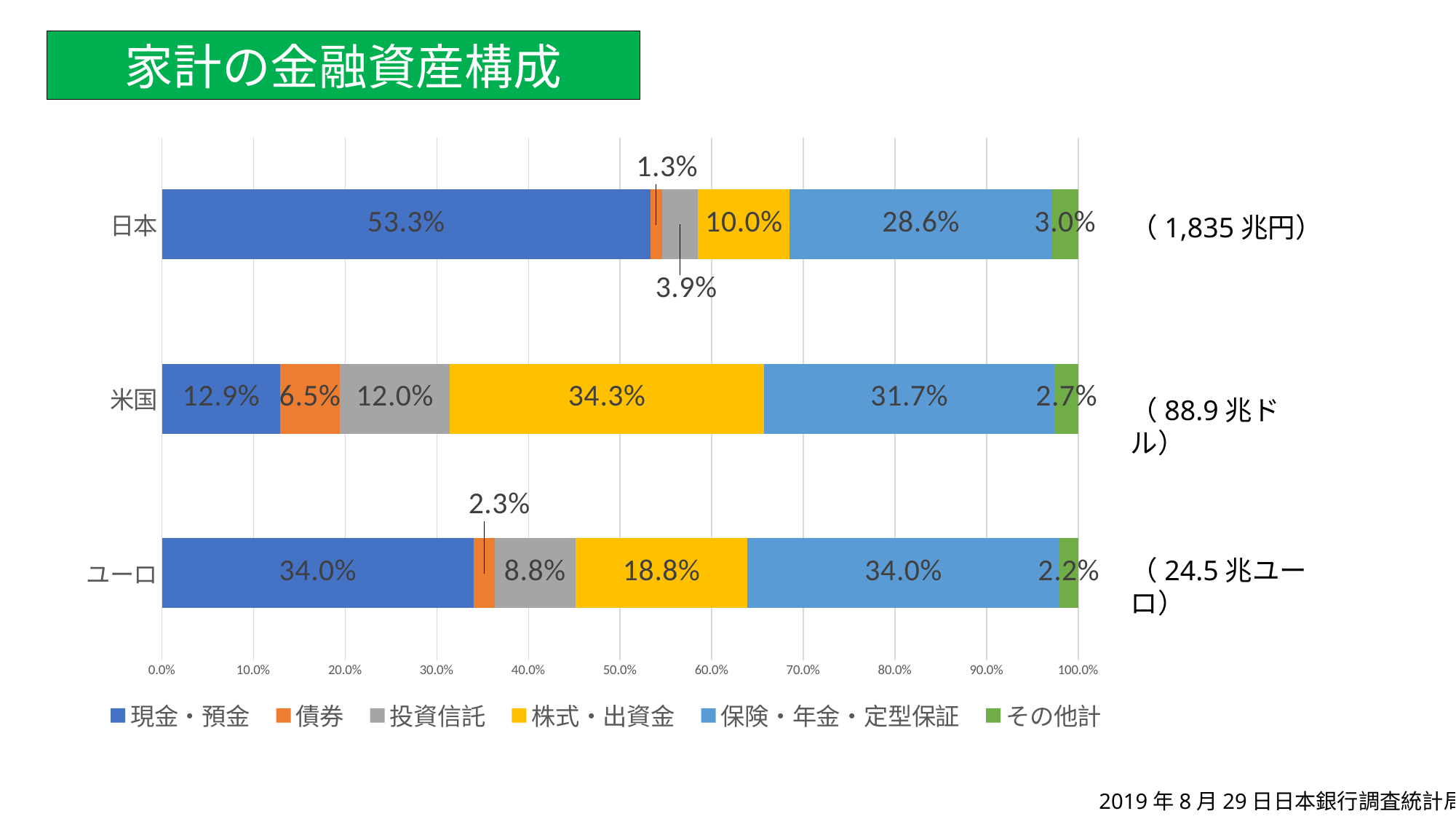
What is the value for 株式・出資金 in the 米国 bar? 34.3% What is the value for 債券 in the 日本 bar? 1.3% What kind of chart is shown on the slide? Stacked bar chart How many series does the legend list? 6 What is the value for 投資信託 in the ユーロ bar? 8.8% What is the title of the slide? 家計の金融資産構成 How many categories (bars) are shown on the chart? 3 Which category has the lowest その他計 share? ユーロ Which category has the highest 現金・預金 share? 日本 What is the difference between the 保険・年金・定型保証 values for 米国 and 日本? 3.1% What is the value for 現金・預金 in the 日本 bar? 53.3% Which is larger, the 株式・出資金 value for ユーロ or for 日本? ユーロ